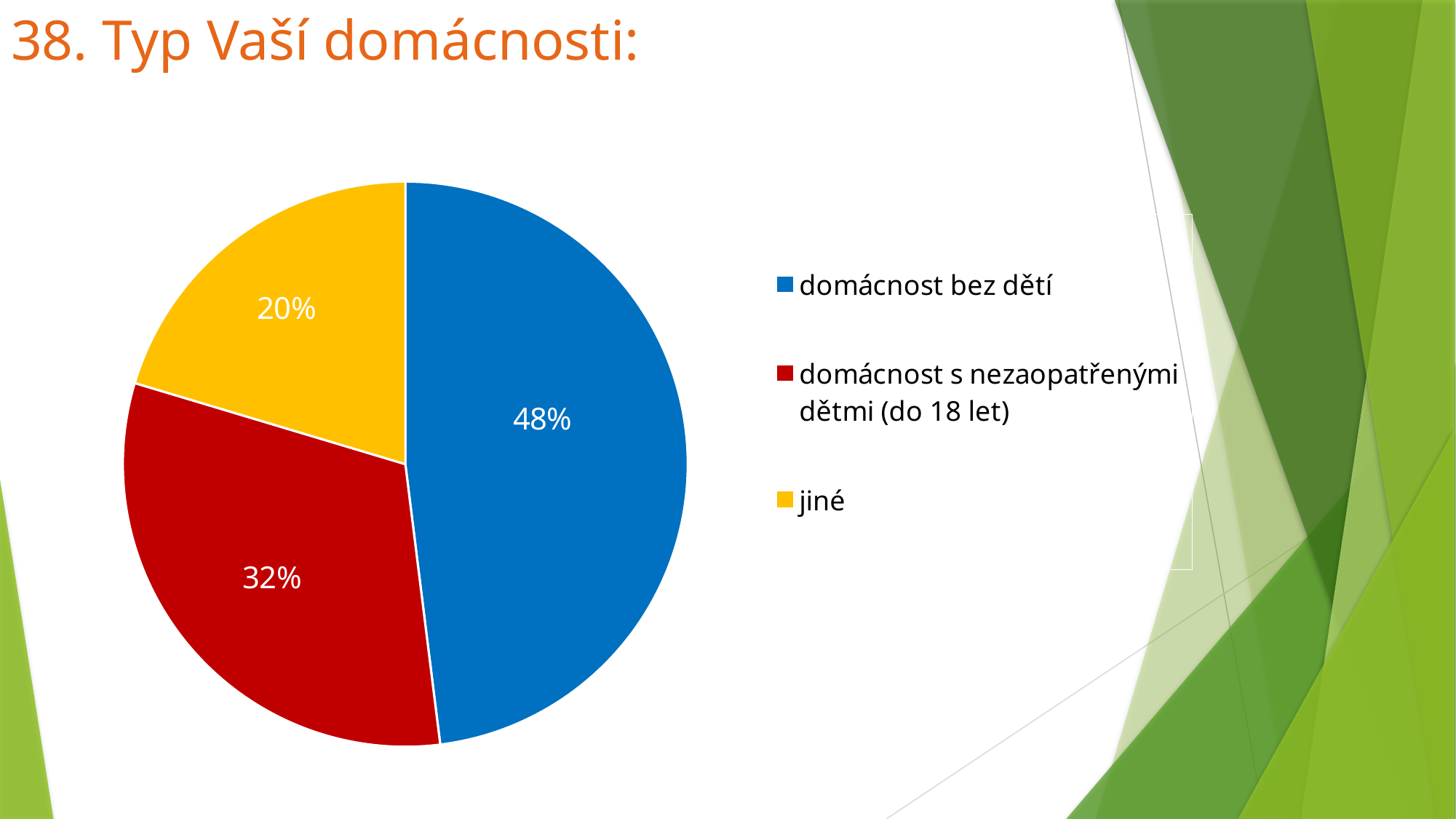
Which category has the largest slice of the pie? domácnost bez dětí Which is larger: the slice for 'domácnost s nezaopatřenými dětmi (do 18 let)' or the slice for 'jiné'? domácnost s nezaopatřenými dětmi (do 18 let) What share of the pie does 'domácnost s nezaopatřenými dětmi (do 18 let)' have? 32% How many slices does the pie chart have? 3 Which category has the smallest slice of the pie? jiné What share of the pie does 'jiné' have? 20% What type of chart is shown on the slide? pie chart What share of the pie does 'domácnost bez dětí' have? 48% What is the difference in percentage points between 'domácnost bez dětí' and 'jiné'? 28 What is the title of the slide containing the chart? 38. Typ Vaší domácnosti: What colour is the slice for 'jiné'? yellow What is the difference in percentage points between 'domácnost bez dětí' and 'domácnost s nezaopatřenými dětmi (do 18 let)'? 16